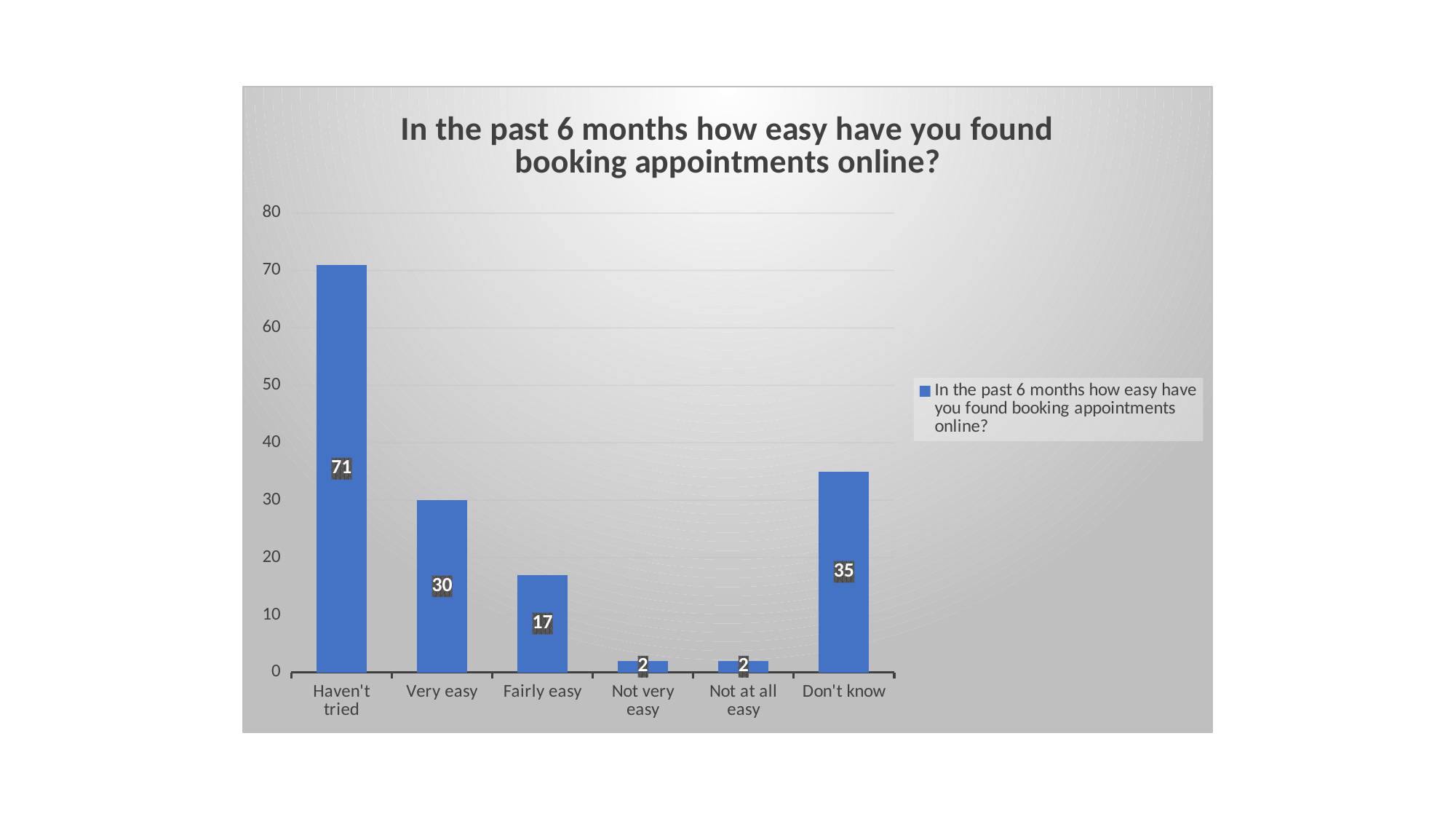
What is the value for "Fairly easy"? 17 How many categories are shown on the x axis? 6 What is the difference between the values for "Haven't tried" and "Don't know"? 36 Which is larger, the value for "Very easy" or the value for "Don't know"? Don't know Is the value for "Haven't tried" greater or less than 60? greater Which category has the highest value? Haven't tried What kind of chart is shown on the slide? Bar chart What is the value for "Very easy"? 30 What is the title of the chart? In the past 6 months how easy have you found booking appointments online? What is the difference between the values for "Very easy" and "Fairly easy"? 13 What is the value for "Don't know"? 35 What is the value for "Haven't tried"? 71